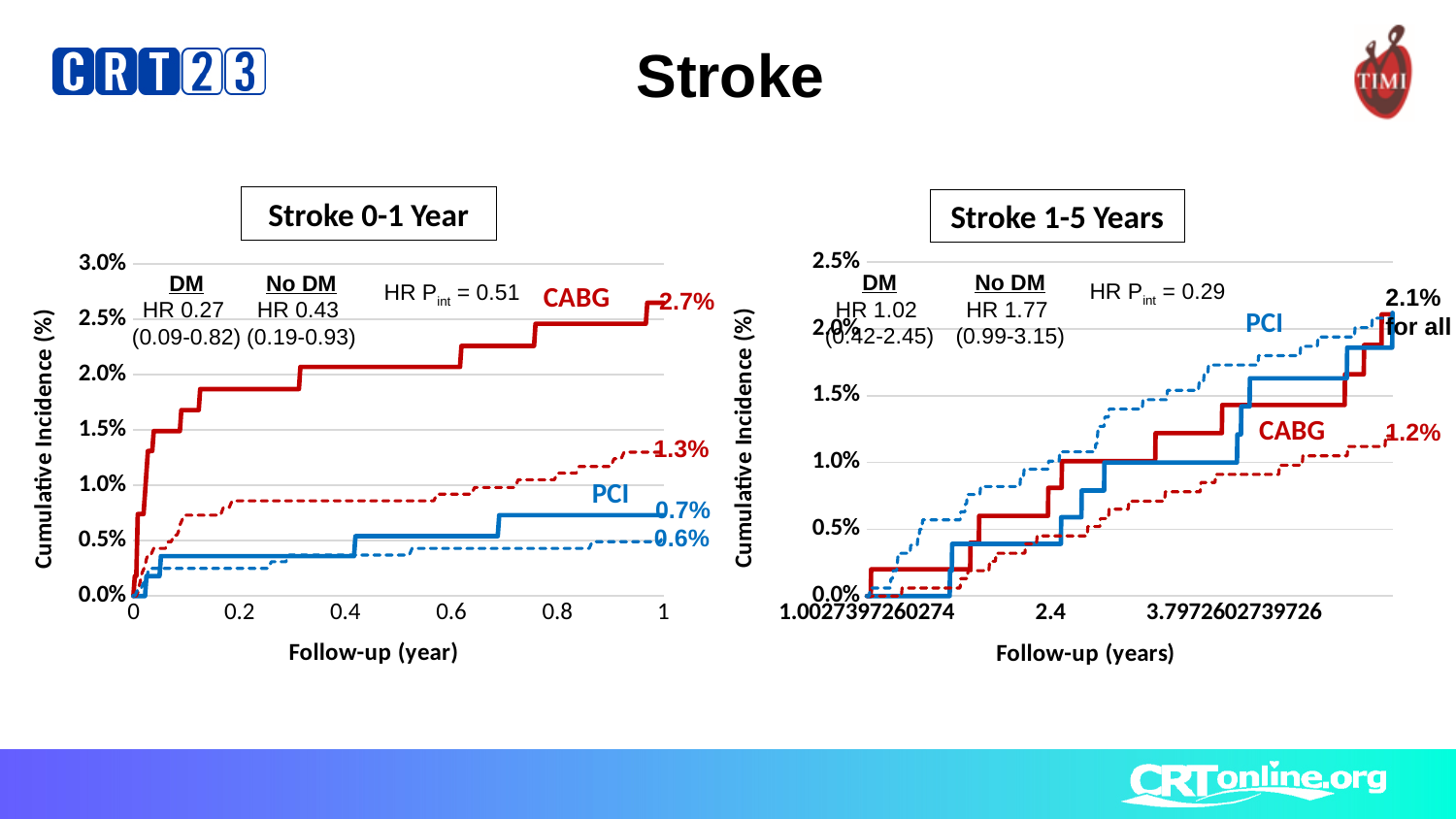
In the Stroke 0-1 Year chart, what is the cumulative incidence labelled at the end of the solid PCI line? 0.7% In the Stroke 0-1 Year chart, what value is labelled at the end of the dashed red line? 1.3% In the Stroke 0-1 Year chart, do the cumulative incidence lines rise or fall along the follow-up axis? Rise In the Stroke 0-1 Year chart, what value is labelled at the end of the dashed blue line? 0.6% In the Stroke 0-1 Year chart, what is the difference between the labelled end values of the solid CABG line (2.7%) and the solid PCI line (0.7%)? 2.0% What kind of chart is the Stroke 0-1 Year chart? Line chart In the Stroke 1-5 Years chart, what cumulative incidence is labelled at the end of the solid PCI and CABG lines? 2.1% In the Stroke 1-5 Years chart, what value is labelled at the end of the dashed lines? 1.2% What is the HR P_int value shown on the Stroke 1-5 Years chart? 0.29 In the Stroke 0-1 Year chart, which line ends higher at 1 year, the solid CABG line or the solid PCI line? CABG In the Stroke 1-5 Years chart, is the end value of the solid CABG line greater or less than 1.5%? greater In the Stroke 0-1 Year chart, what is the cumulative incidence labelled at the end of the solid CABG line? 2.7%